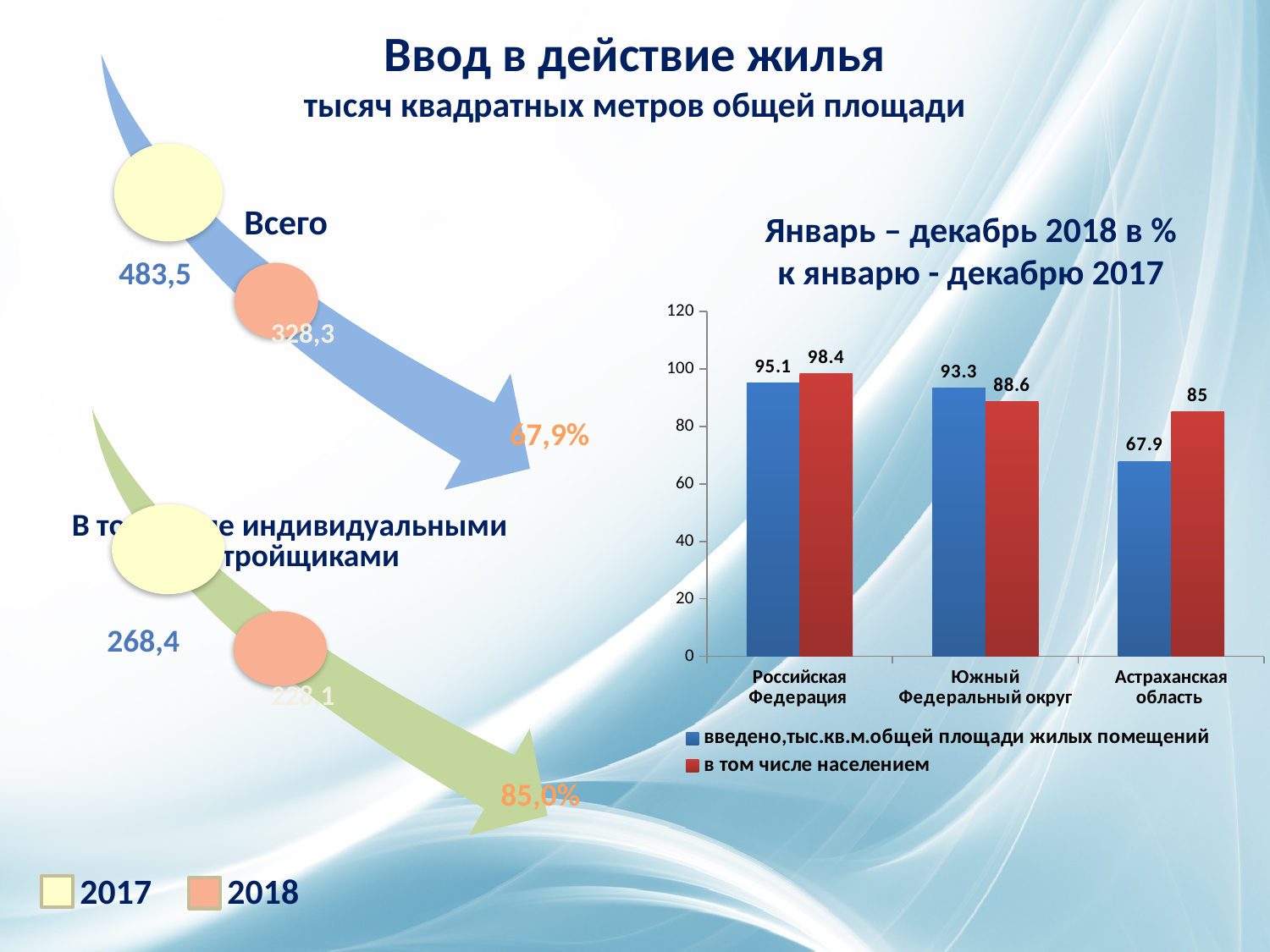
In the bar chart 'Январь – декабрь 2018 в % к январю - декабрю 2017', what is the difference between the two series for Астраханская область? 17.1 How many series does the legend of the bar chart 'Январь – декабрь 2018 в % к январю - декабрю 2017' list? 2 In the bar chart 'Январь – декабрь 2018 в % к январю - декабрю 2017', what colour are the bars for 'в том числе населением'? red In the bar chart 'Январь – декабрь 2018 в % к январю - декабрю 2017', for Южный Федеральный округ, which series has the larger value? введено,тыс.кв.м.общей площади жилых помещений In the bar chart 'Январь – декабрь 2018 в % к январю - декабрю 2017', what is the value of 'введено,тыс.кв.м.общей площади жилых помещений' for Российская Федерация? 95.1 What kind of chart is 'Январь – декабрь 2018 в % к январю - декабрю 2017'? bar chart In the bar chart 'Январь – декабрь 2018 в % к январю - декабрю 2017', what is the value of 'в том числе населением' for Южный Федеральный округ? 88.6 In the bar chart 'Январь – декабрь 2018 в % к январю - декабрю 2017', which category has the highest value for 'в том числе населением'? Российская Федерация In the bar chart 'Январь – декабрь 2018 в % к январю - декабрю 2017', what is the value of 'в том числе населением' for Астраханская область? 85 How many categories are shown on the x axis of the bar chart 'Январь – декабрь 2018 в % к январю - декабрю 2017'? 3 In the bar chart 'Январь – декабрь 2018 в % к январю - декабрю 2017', which category has the lowest value for 'введено,тыс.кв.м.общей площади жилых помещений'? Астраханская область In the bar chart 'Январь – декабрь 2018 в % к январю - декабрю 2017', is the value of 'введено,тыс.кв.м.общей площади жилых помещений' for Астраханская область greater or less than 80? less